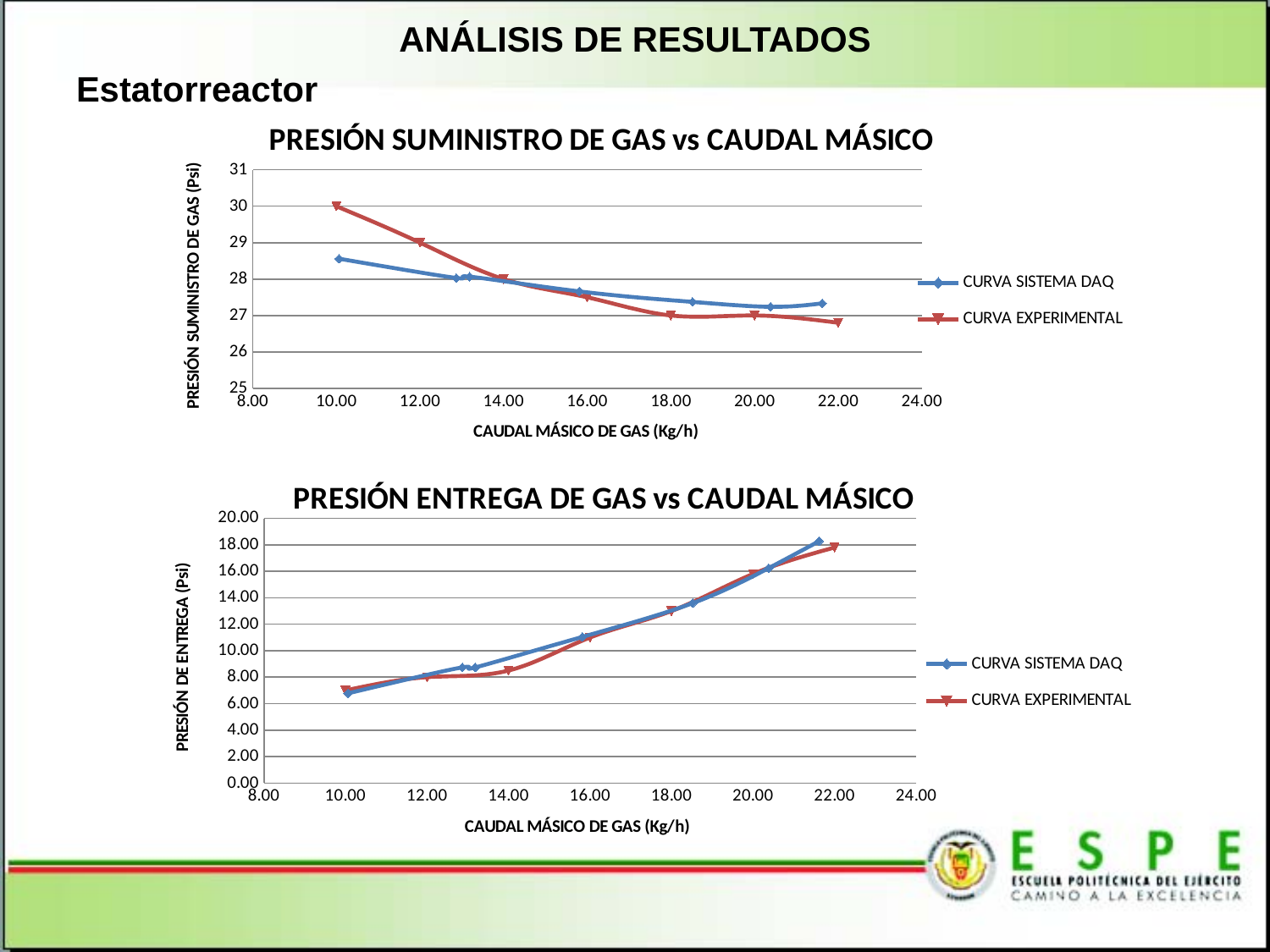
In the bottom chart, 'PRESIÓN ENTREGA DE GAS vs CAUDAL MÁSICO', do the values of CURVA SISTEMA DAQ rise or fall as the mass flow increases? rise In the top chart, 'PRESIÓN SUMINISTRO DE GAS vs CAUDAL MÁSICO', is the CURVA EXPERIMENTAL value at 10.00 Kg/h greater or less than 29? greater What type of chart is the bottom chart, 'PRESIÓN ENTREGA DE GAS vs CAUDAL MÁSICO'? line chart How many series does the legend of the top chart, 'PRESIÓN SUMINISTRO DE GAS vs CAUDAL MÁSICO', list? 2 In the bottom chart, 'PRESIÓN ENTREGA DE GAS vs CAUDAL MÁSICO', is the CURVA SISTEMA DAQ value at about 22.00 Kg/h greater or less than 16.00? greater In the top chart, 'PRESIÓN SUMINISTRO DE GAS vs CAUDAL MÁSICO', which series has the higher value at 10.00 Kg/h? CURVA EXPERIMENTAL What is the x-axis label of the bottom chart, 'PRESIÓN ENTREGA DE GAS vs CAUDAL MÁSICO'? CAUDAL MÁSICO DE GAS (Kg/h) What type of chart is the top chart, 'PRESIÓN SUMINISTRO DE GAS vs CAUDAL MÁSICO'? line chart In the top chart, 'PRESIÓN SUMINISTRO DE GAS vs CAUDAL MÁSICO', do the values of CURVA EXPERIMENTAL rise or fall as the mass flow increases? fall In the top chart, 'PRESIÓN SUMINISTRO DE GAS vs CAUDAL MÁSICO', is the CURVA SISTEMA DAQ value at 10.00 Kg/h greater or less than 29? less How many series does the legend of the bottom chart, 'PRESIÓN ENTREGA DE GAS vs CAUDAL MÁSICO', list? 2 What is the y-axis label of the top chart, 'PRESIÓN SUMINISTRO DE GAS vs CAUDAL MÁSICO'? PRESIÓN SUMINISTRO DE GAS (Psi)